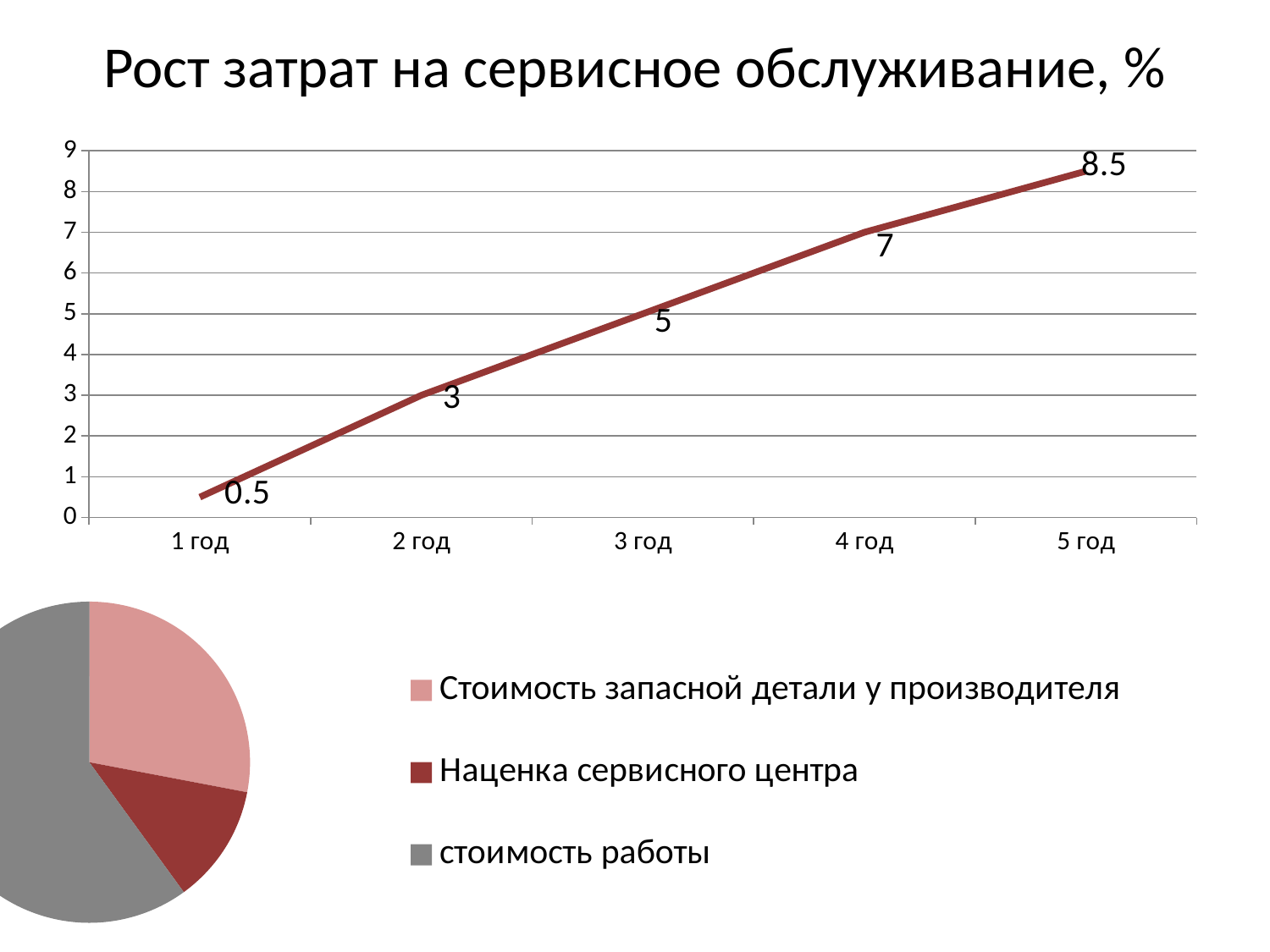
In the line chart at the top, what is the difference between the values for 4 год and 2 год? 4 In the pie chart at the bottom, which category has the largest slice? стоимость работы In the line chart at the top, which year has the highest value? 5 год In the line chart at the top, do the values rise or fall from 1 год to 5 год? rise In the line chart at the top, what is the value for 1 год? 0.5 In the line chart at the top, what is the value for 5 год? 8.5 How many data points are plotted in the line chart at the top? 5 What type of chart is shown at the top of the slide? line chart In the line chart at the top, what is the difference between the values for 5 год and 1 год? 8 In the pie chart at the bottom, which category has the smallest slice? Наценка сервисного центра In the line chart at the top, which year has the lowest value? 1 год In the line chart at the top, what is the value for 3 год? 5